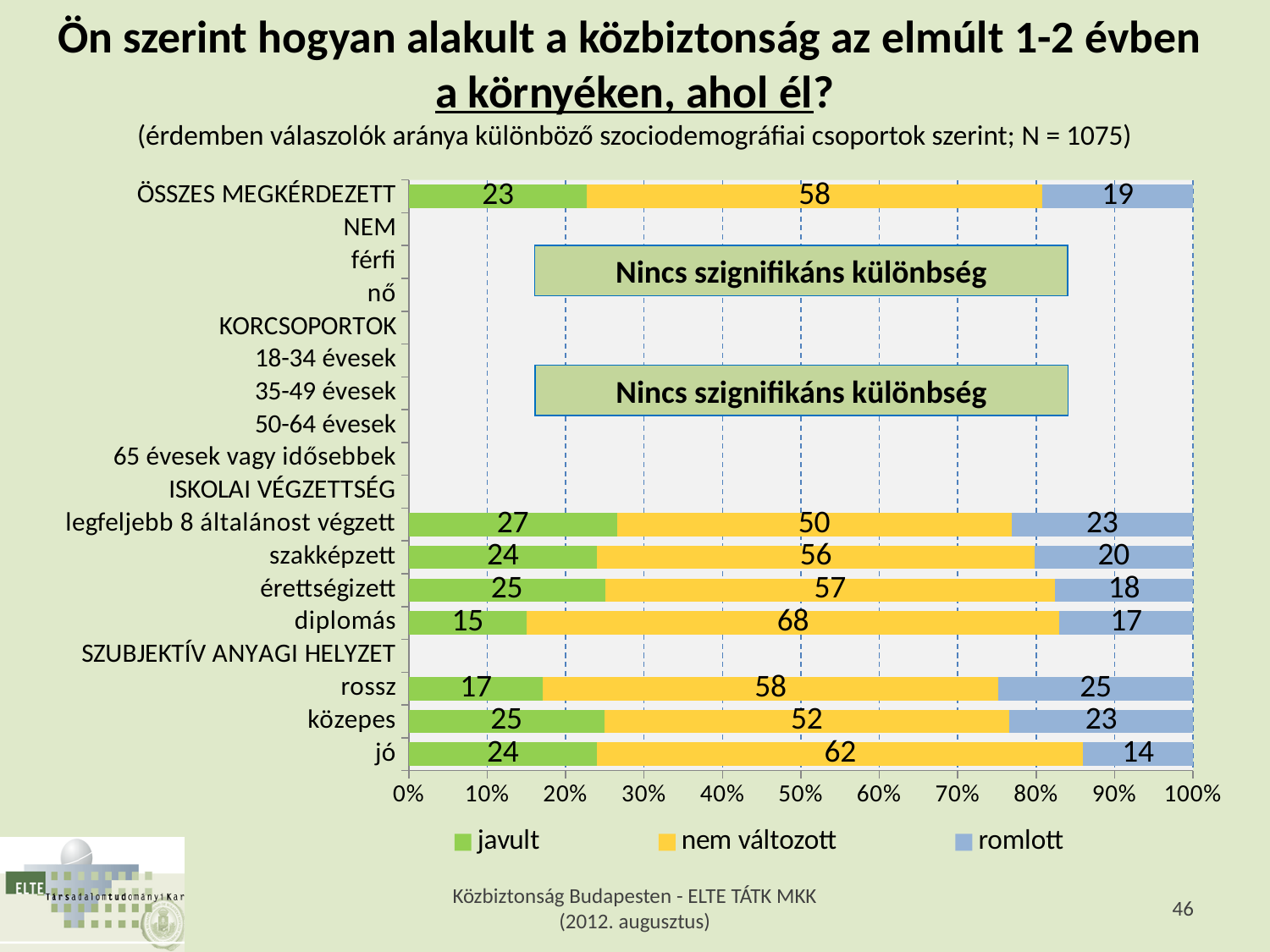
What is the 'javult' value for legfeljebb 8 általánost végzett? 27 What is the 'nem változott' value for diplomás? 68 Which is larger: the 'javult' value for érettségizett or for diplomás? érettségizett Among the categories with plotted bars, which has the highest 'nem változott' value? diplomás What kind of chart is shown on the slide? stacked bar chart What is the total of the stacked bar for szakképzett? 100 What text appears in the boxes placed over the NEM and KORCSOPORTOK rows? Nincs szignifikáns különbség What is the 'romlott' value for rossz? 25 Among the categories with plotted bars, which has the lowest 'romlott' value? jó What is the 'javult' value for ÖSSZES MEGKÉRDEZETT? 23 How many series does the legend list? 3 What is the difference between the 'nem változott' values for jó and közepes? 10